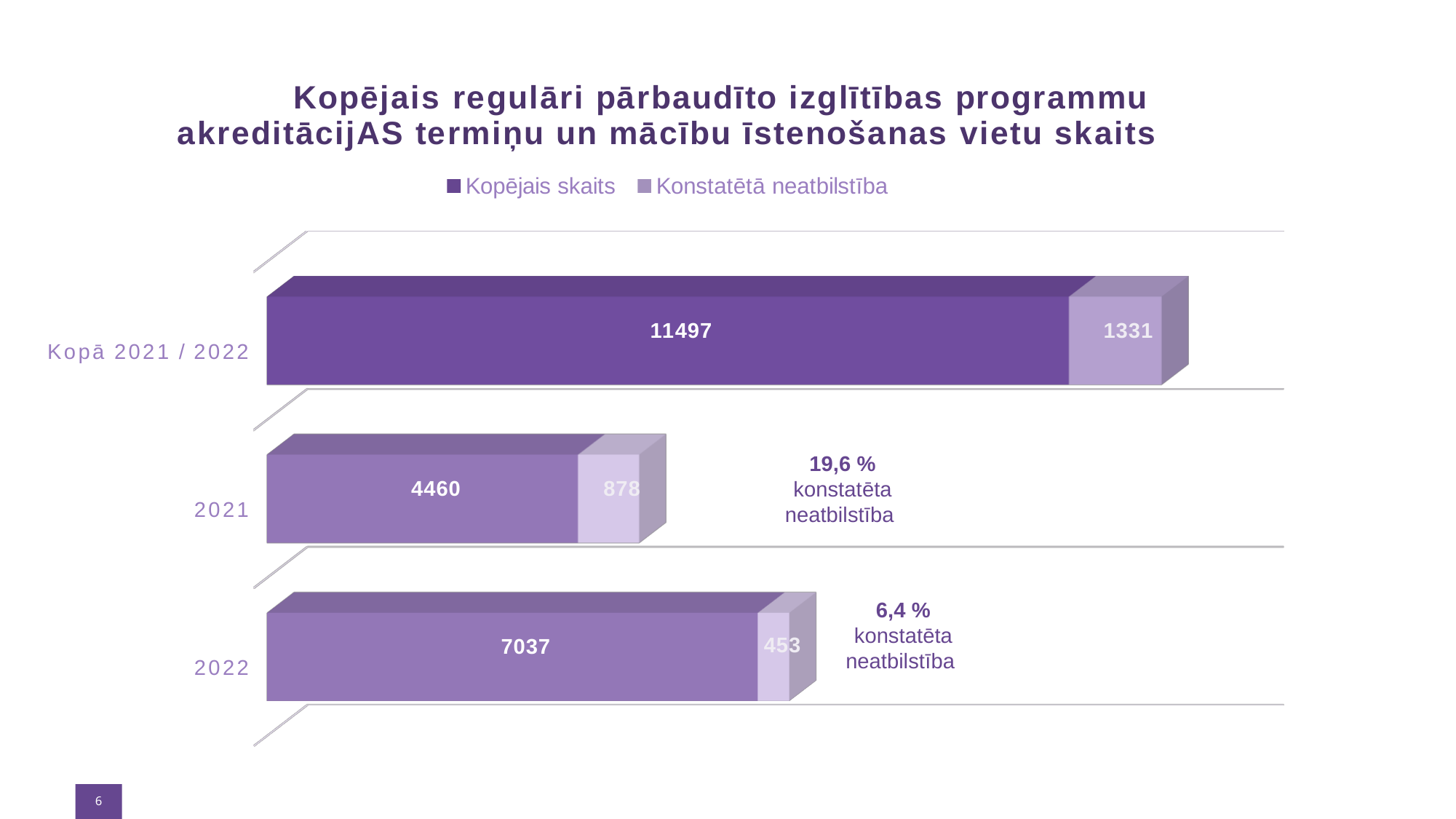
What is the difference between the Kopējais skaits values for 2022 and 2021? 2577 What is the value of Konstatētā neatbilstība for Kopā 2021 / 2022? 1331 Which category has the highest value for Kopējais skaits? Kopā 2021 / 2022 What kind of chart is shown on the slide? Stacked bar chart What is the value of Kopējais skaits for Kopā 2021 / 2022? 11497 Which category has the lowest value for Konstatētā neatbilstība? 2022 Which is larger, the Konstatētā neatbilstība value for 2021 or for 2022? 2021 How many series does the legend list? 2 How many categories are shown on the chart? 3 What is the value of Kopējais skaits for 2022? 7037 What is the value of Konstatētā neatbilstība for 2021? 878 What percentage of konstatēta neatbilstība is annotated next to the 2021 bar? 19,6 %